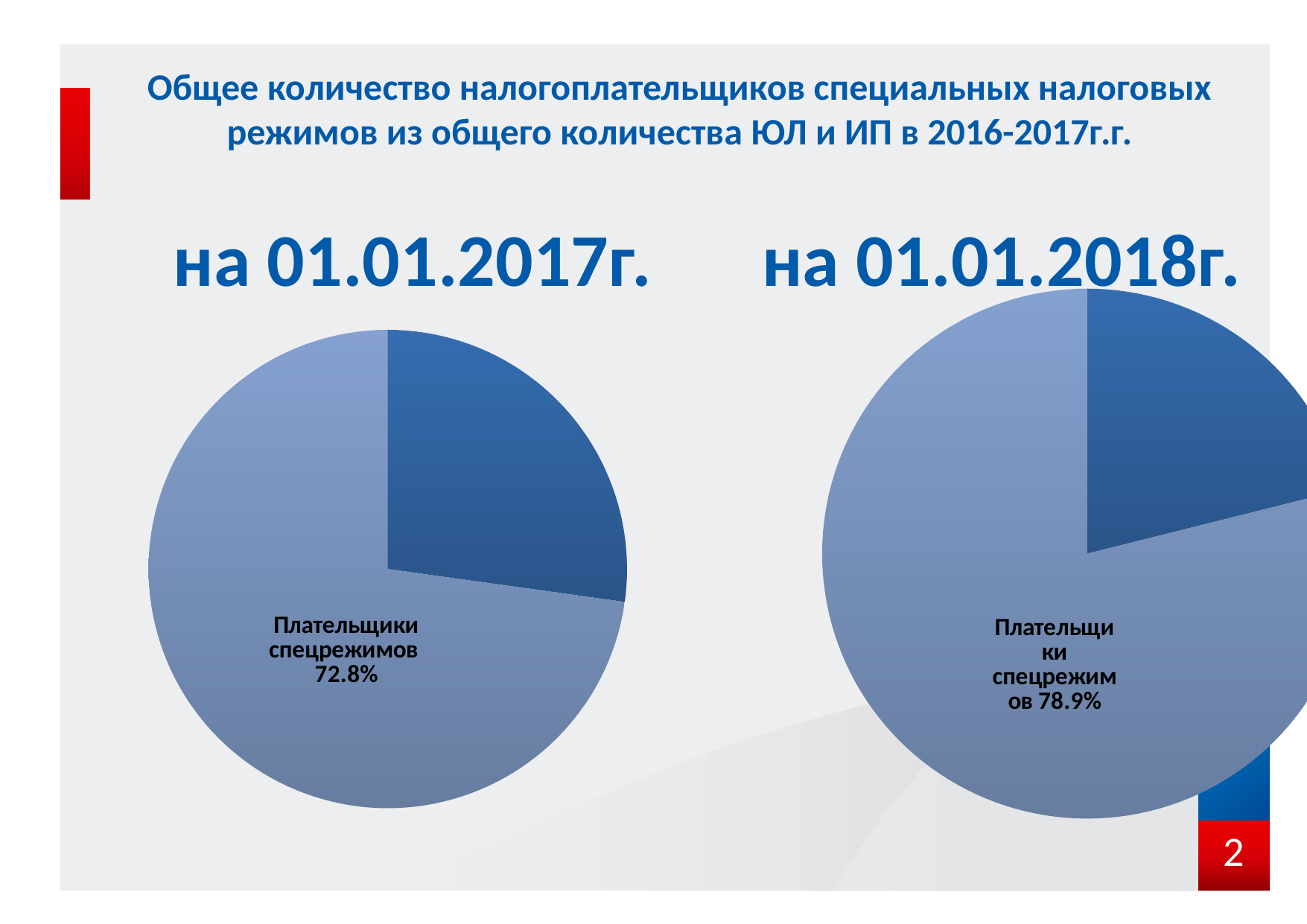
How many slices does the pie chart for 01.01.2018 have? 2 In the pie chart for 01.01.2018, what share is labelled for Плательщики спецрежимов? 78.9% In the pie chart for 01.01.2017, what share is labelled for Плательщики спецрежимов? 72.8% In the pie chart for 01.01.2017, is the labelled slice Плательщики спецрежимов larger or smaller than the unlabelled slice? Larger What kind of chart is used on the right side of the slide for 01.01.2018? Pie chart How many pie charts are shown on the slide? 2 What kind of chart is used on the left side of the slide for 01.01.2017? Pie chart Which chart shows the larger share for Плательщики спецрежимов, the one for 01.01.2017 or the one for 01.01.2018? 01.01.2018 How many slices does the pie chart for 01.01.2017 have? 2 What date heading is shown above the left pie chart? на 01.01.2017г. By how many percentage points did the share of Плательщики спецрежимов change from the 01.01.2017 chart to the 01.01.2018 chart? 6.1 What date heading is shown above the right pie chart? на 01.01.2018г.